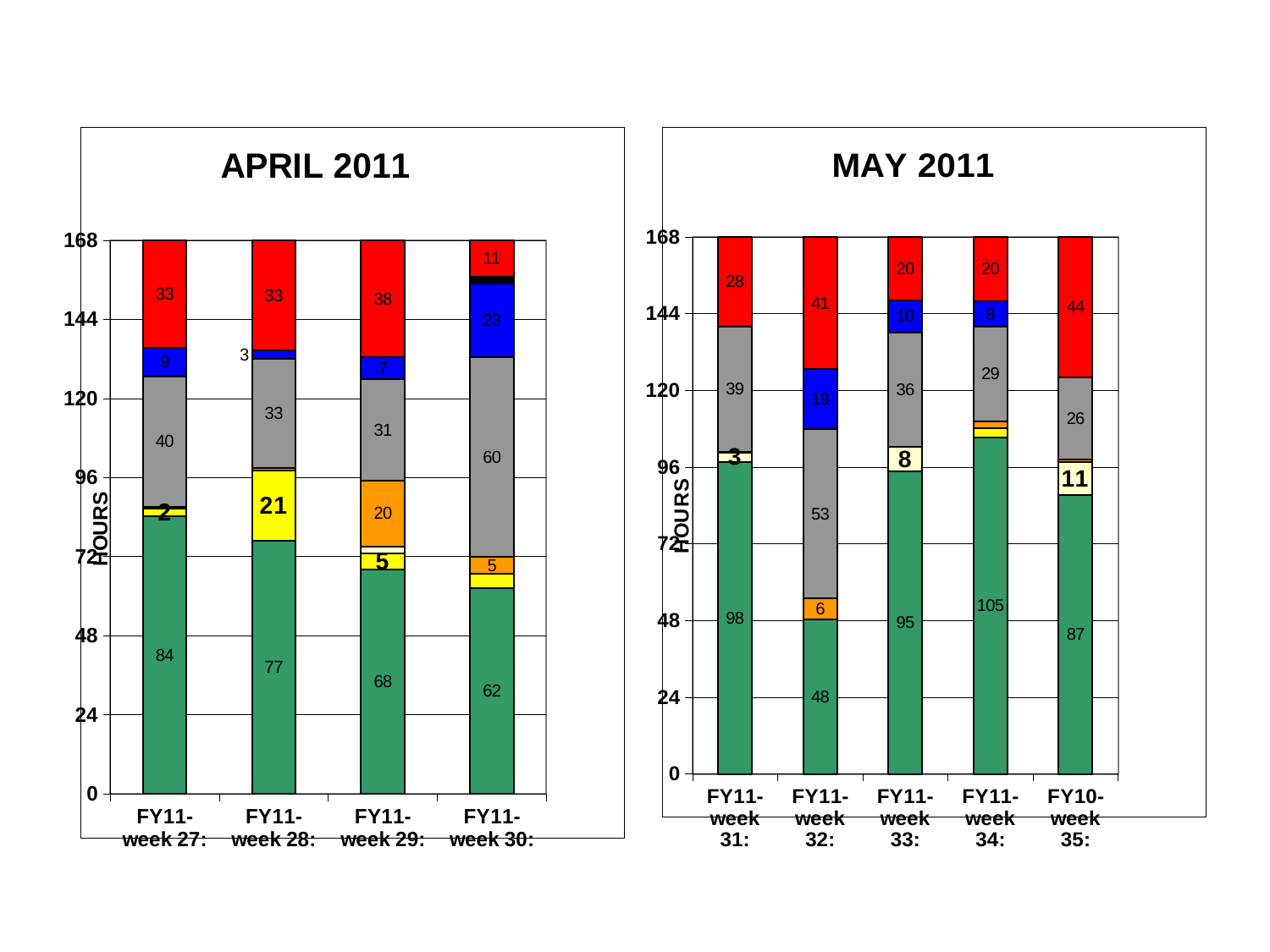
On the MAY 2011 chart, which week has the largest green segment? FY11-week 34 How many categories (weeks) are shown on the MAY 2011 chart? 5 How many categories (weeks) are shown on the APRIL 2011 chart? 4 On the APRIL 2011 chart, do the green segment values rise or fall from FY11-week 27 to FY11-week 30? Fall On the APRIL 2011 chart, what is the value of the green segment for FY11-week 27? 84 What is the label on the vertical axis of the MAY 2011 chart? HOURS What kind of chart is the APRIL 2011 chart? Stacked bar chart On the MAY 2011 chart, what is the value of the green segment for FY11-week 34? 105 On the APRIL 2011 chart, what is the difference between the green segment for FY11-week 27 and the green segment for FY11-week 30? 22 On the APRIL 2011 chart, what is the value of the gray segment for FY11-week 30? 60 On the MAY 2011 chart, which is larger: the red segment for FY11-week 32 or the red segment for FY10-week 35? FY10-week 35 On the APRIL 2011 chart, which week has the smallest green segment? FY11-week 30